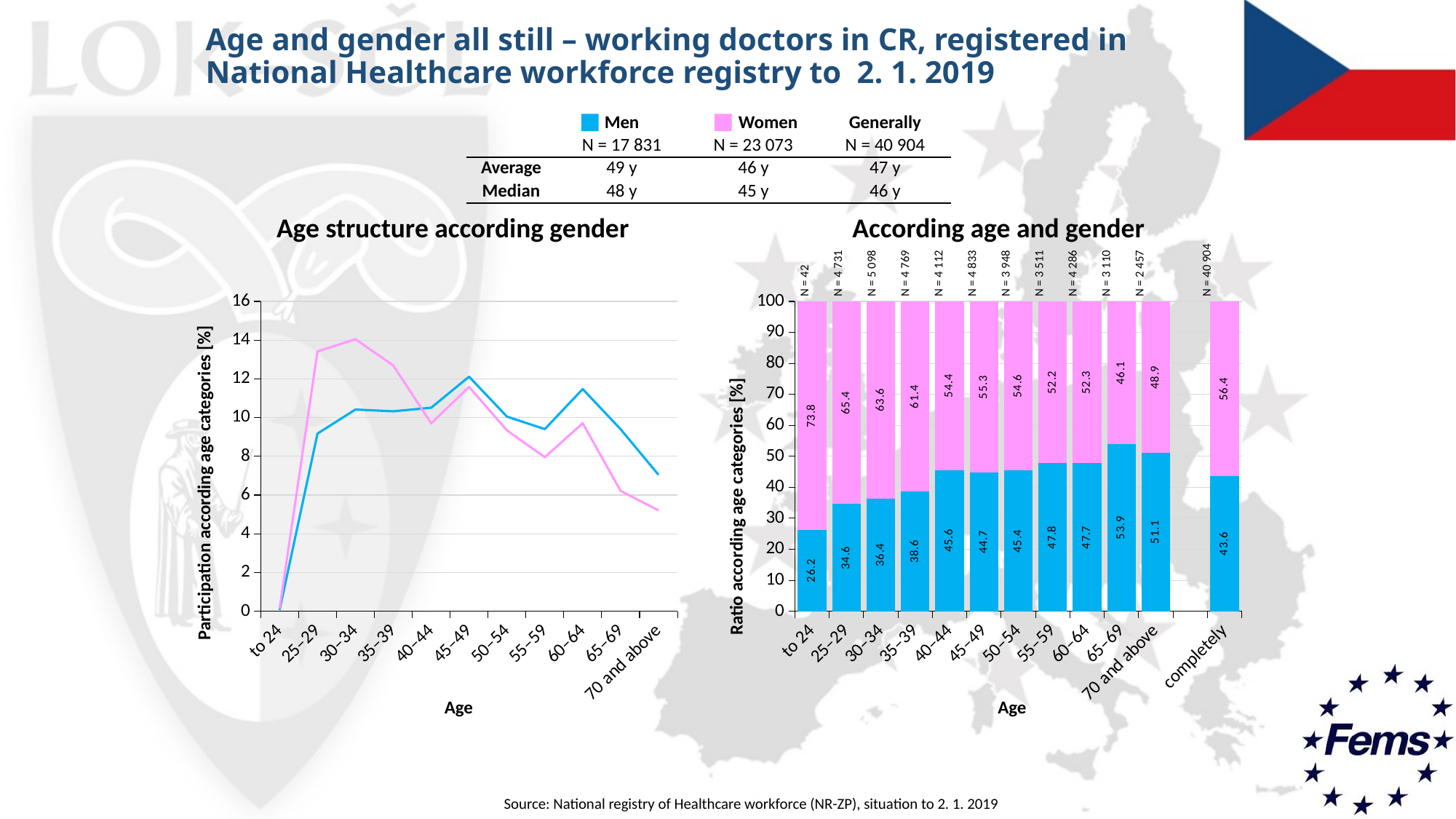
In the 'Age structure according gender' chart, how many age categories are shown on the x axis? 11 In the 'According age and gender' chart, what is the Women value for the 'completely' bar? 56.4 In the 'According age and gender' chart, is the Men value larger for 35–39 or for 40–44? 40–44 In the 'According age and gender' chart, how many series does the chart show? 2 In the 'Age structure according gender' chart, is the Men value for '70 and above' greater or less than 8? less In the 'According age and gender' chart, what is the Women value for the 'to 24' age group? 73.8 In the 'According age and gender' chart, which age group has the lowest Men share? to 24 In the 'Age structure according gender' chart, is the Women value for 30–34 greater or less than 12? greater In the 'According age and gender' chart, what is the Men value for the 65–69 age group? 53.9 In the 'According age and gender' chart, what is the difference between the Women and Men values for the 25–29 age group? 30.8 What type of chart is 'Age structure according gender'? Line chart In the 'According age and gender' chart, which age group has the highest Men share? 65–69